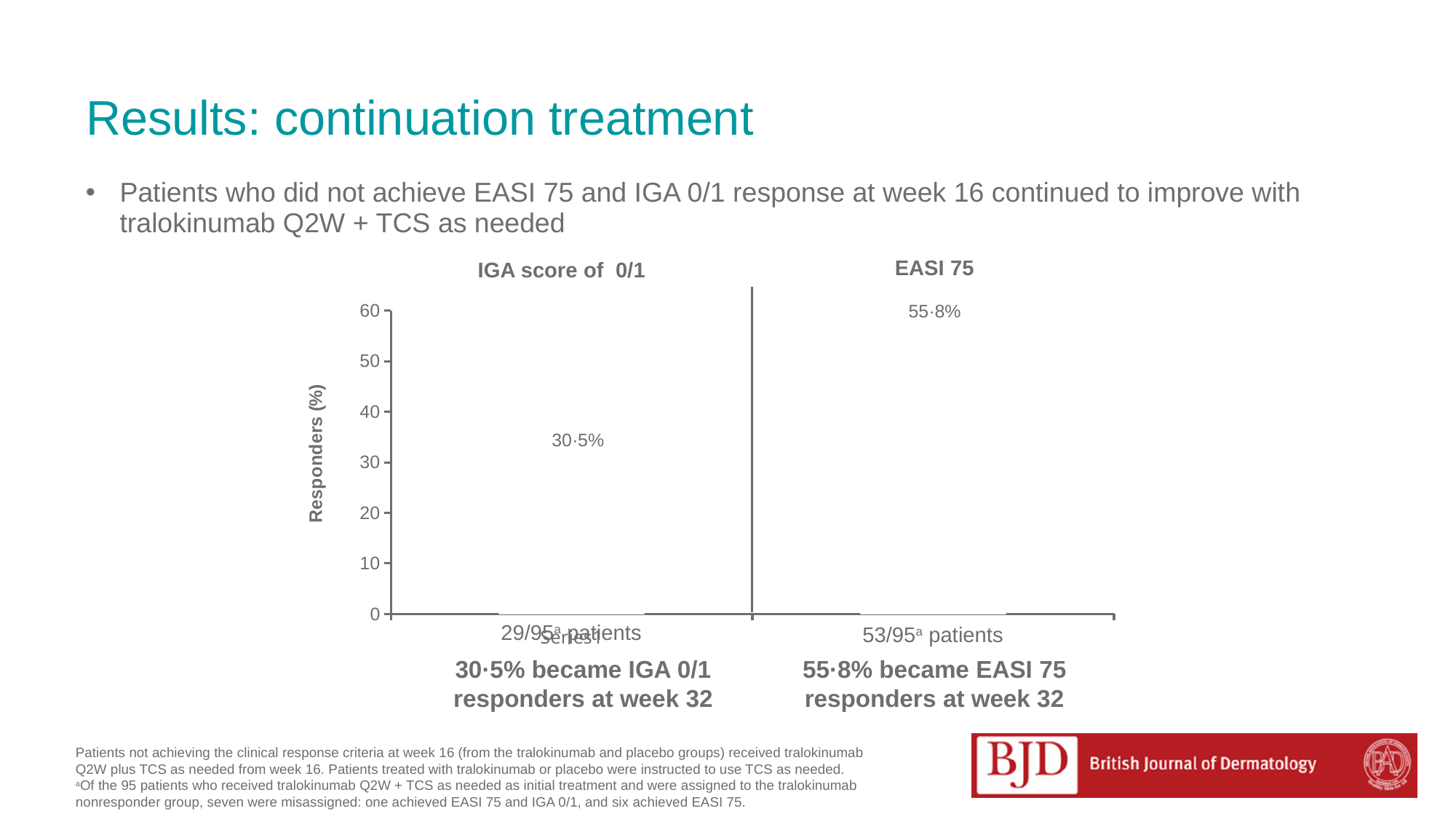
Is the responder percentage for IGA score of 0/1 greater or less than 40? less What percentage of patients became IGA 0/1 responders at week 32? 30·5% What is the label of the vertical axis of the chart? Responders (%) What kind of chart is shown on the slide? bar chart How many patients out of 95 became EASI 75 responders at week 32? 53/95 How many outcome categories are shown in the chart? 2 Is the responder percentage for EASI 75 larger or smaller than that for IGA score of 0/1? larger What is the difference in responder percentage between EASI 75 and IGA score of 0/1? 25·3% What percentage of patients became EASI 75 responders at week 32? 55·8% Which outcome has the lower responder percentage? IGA score of 0/1 Which outcome has the higher responder percentage, IGA score of 0/1 or EASI 75? EASI 75 Is the responder percentage for EASI 75 greater or less than 50? greater